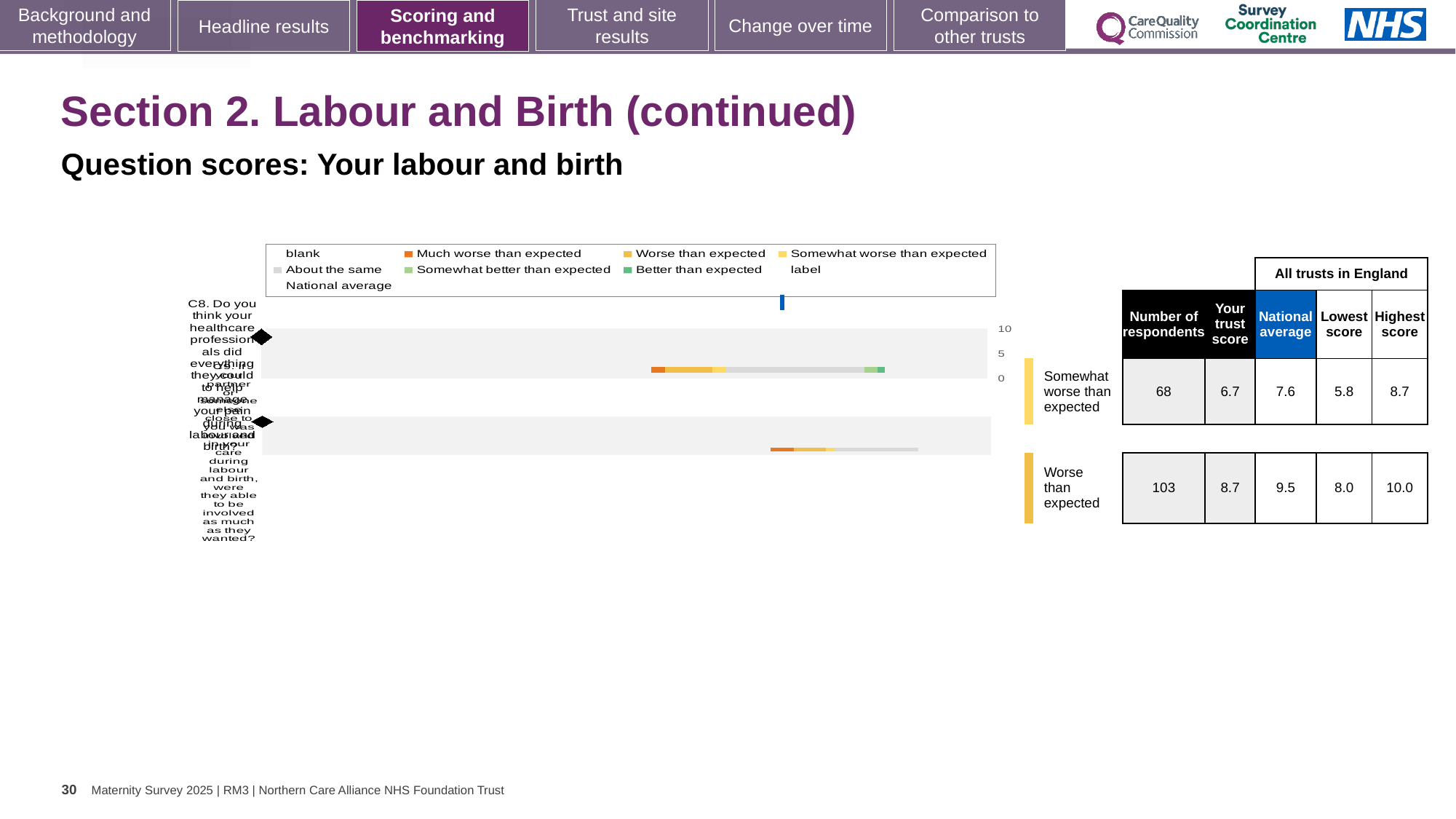
In the table beside the chart, how many respondents are listed for the row rated 'Somewhat worse than expected'? 68 In the table beside the chart, what is the national average for the row rated 'Worse than expected'? 9.5 In the table beside the chart, what is the difference between the national average and the trust score for the row rated 'Somewhat worse than expected'? 0.9 In the table beside the chart, which row has more respondents, 'Somewhat worse than expected' or 'Worse than expected'? Worse than expected How many question rows (bars) are plotted in the chart? 2 In the table beside the chart, what is the trust score for the row rated 'Somewhat worse than expected'? 6.7 What is the highest tick value shown on the chart's score axis? 10 What colour represents 'Better than expected' in the chart legend? green In the table beside the chart, what is the highest score among all trusts in England for the row rated 'Worse than expected'? 10.0 In the table beside the chart, what is the lowest score among all trusts in England for the row rated 'Somewhat worse than expected'? 5.8 What colour represents 'Much worse than expected' in the chart legend? orange What kind of chart is shown on the slide? bar chart